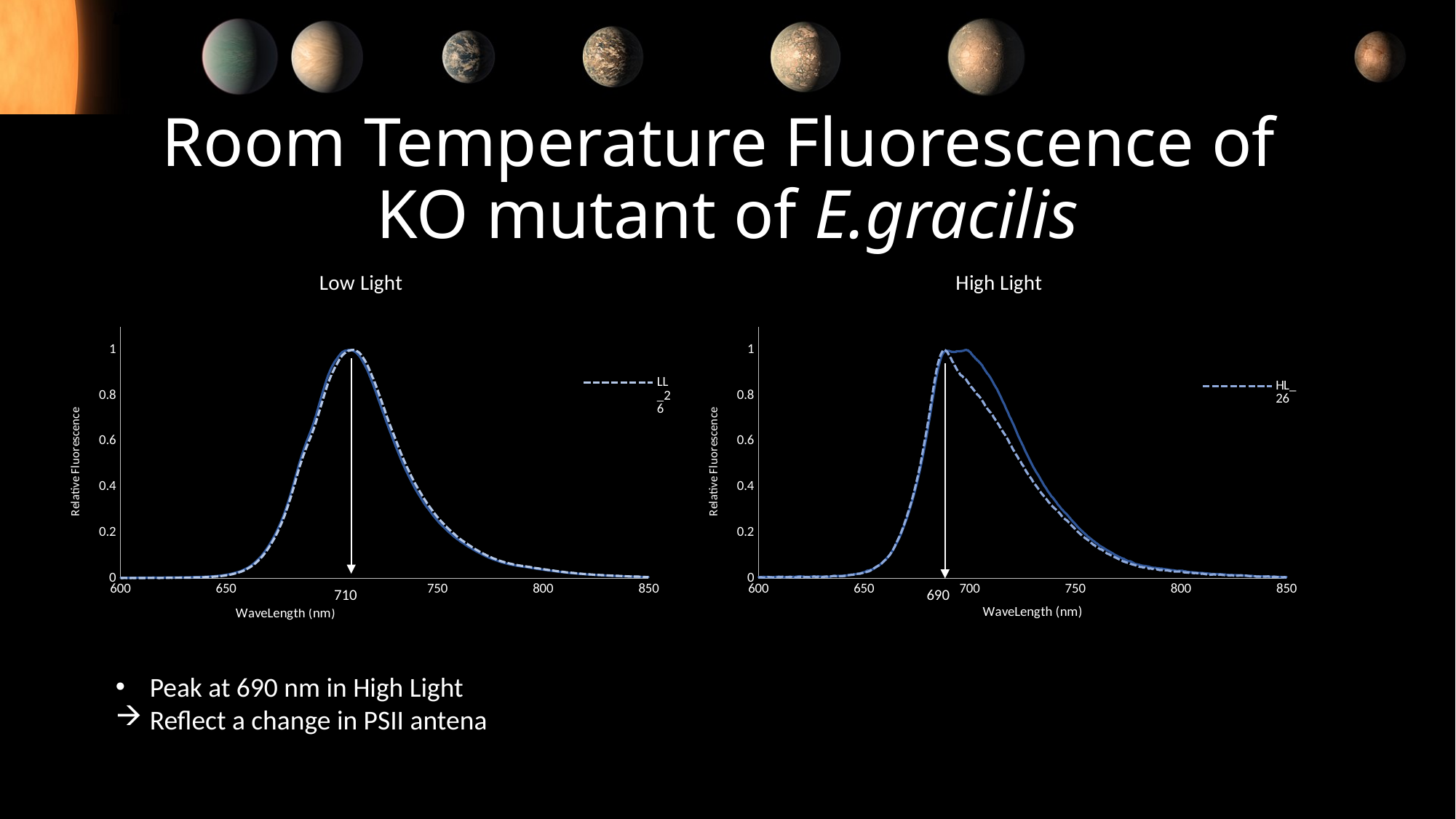
On the High Light chart, is the relative fluorescence at 650 nm greater or less than 0.2? less On the Low Light chart, at what wavelength is the fluorescence peak marked by the arrow? 710 On the High Light chart, what is the legend entry shown? HL_26 On the High Light chart, is the relative fluorescence at 700 nm greater or less than 0.6? greater On the Low Light chart, is the relative fluorescence at 750 nm greater or less than 0.6? less What kind of chart is the Low Light chart? line chart On the High Light chart, at what wavelength is the fluorescence peak marked by the arrow? 690 On the Low Light chart, do the values rise or fall along the x axis from 710 nm to 850 nm? fall Which chart has its peak at the shorter wavelength, Low Light or High Light? High Light On the High Light chart, do the values rise or fall along the x axis from 650 nm to 690 nm? rise On the Low Light chart, what is the label of the y axis? Relative Fluorescence